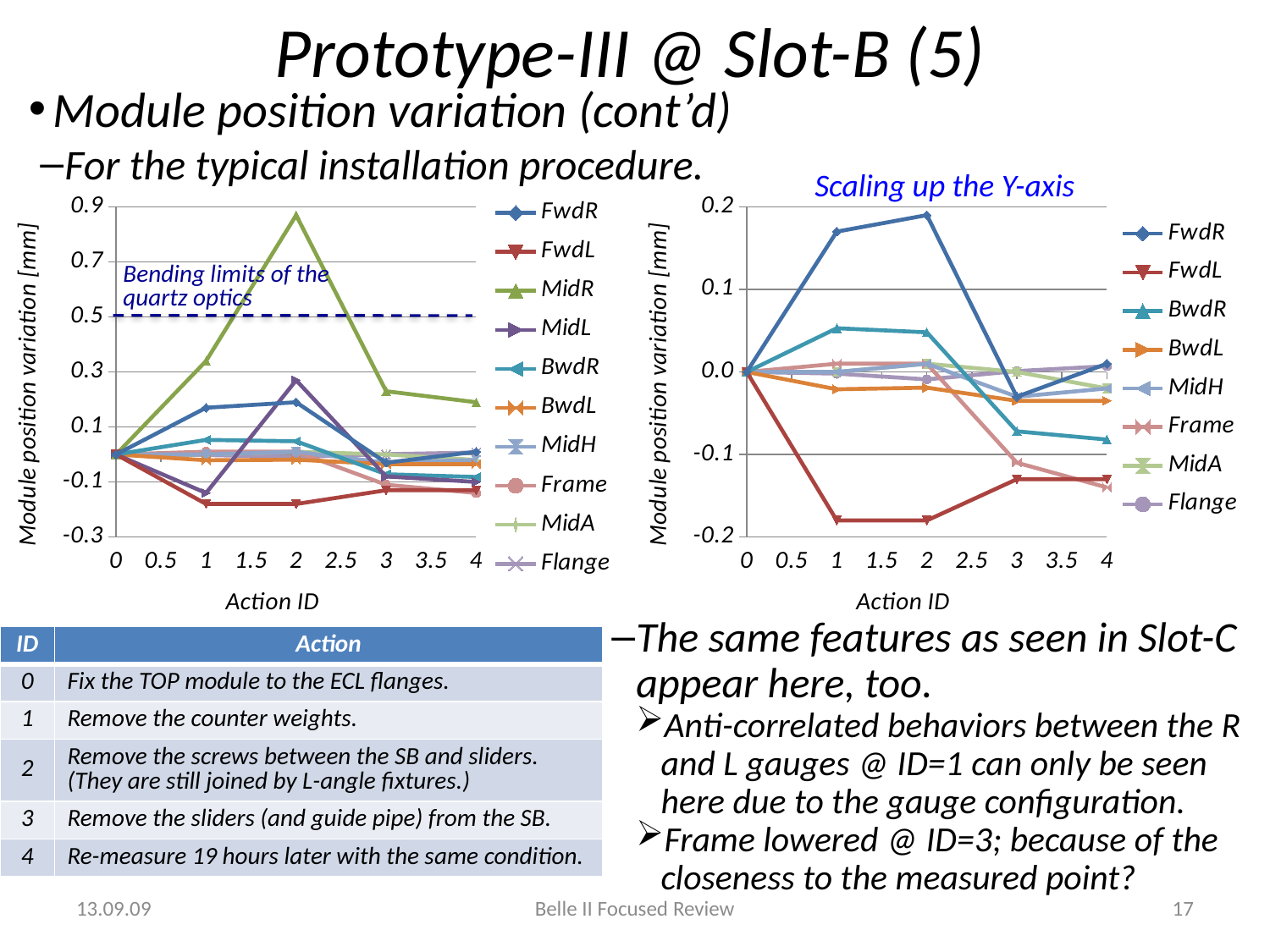
In the left chart, which series has the lowest value at Action ID 1? FwdL How many series does the legend of the left chart list? 10 In the right chart (Scaling up the Y-axis), is the value of FwdL at Action ID 1 greater or less than -0.1? less In the left chart, is the value of FwdR at Action ID 1 greater or less than 0.3? less How many series does the legend of the right chart (Scaling up the Y-axis) list? 8 In the right chart (Scaling up the Y-axis), does the FwdR series rise or fall from Action ID 2 to Action ID 3? fall What type of chart is the left chart on the slide? line chart In the left chart, is the value of MidR at Action ID 2 greater or less than 0.5? greater What does the dashed horizontal line in the left chart represent, according to its label? Bending limits of the quartz optics In the left chart, which series has the highest value at Action ID 2? MidR In the right chart (Scaling up the Y-axis), which is larger at Action ID 1, FwdR or BwdR? FwdR